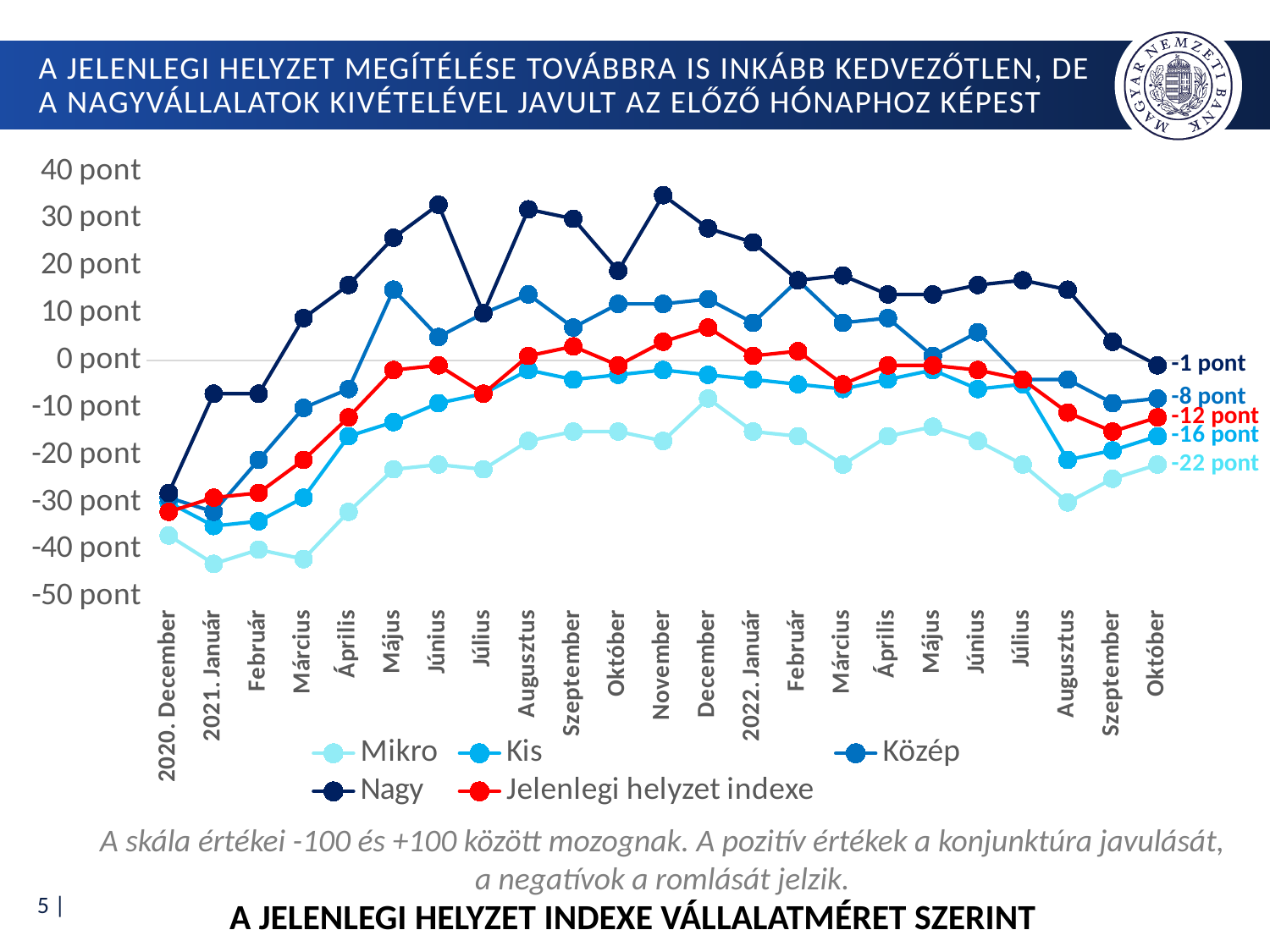
What is the value of the Kis series at the last point (Október 2022)? -16 pont What is the value of the Közép series at the last point (Október 2022)? -8 pont What is the value of the Nagy series in Október (2022), the last point on the chart? -1 pont Which series has the lowest value at the last point (Október 2022)? Mikro What is the value of the Mikro series at the last point (Október 2022)? -22 pont How many months (x-axis categories) are plotted on the chart? 23 Which series has the highest value at the last point (Október 2022)? Nagy Is the value of the Nagy series in 2021 November greater or less than 30 pont? greater What kind of chart is shown on the slide? Line chart What is the difference between the Nagy and Mikro values at the last point (Október 2022)? 21 pont What is the value of the Jelenlegi helyzet indexe series at the last point (Október 2022)? -12 pont How many series does the legend list? 5